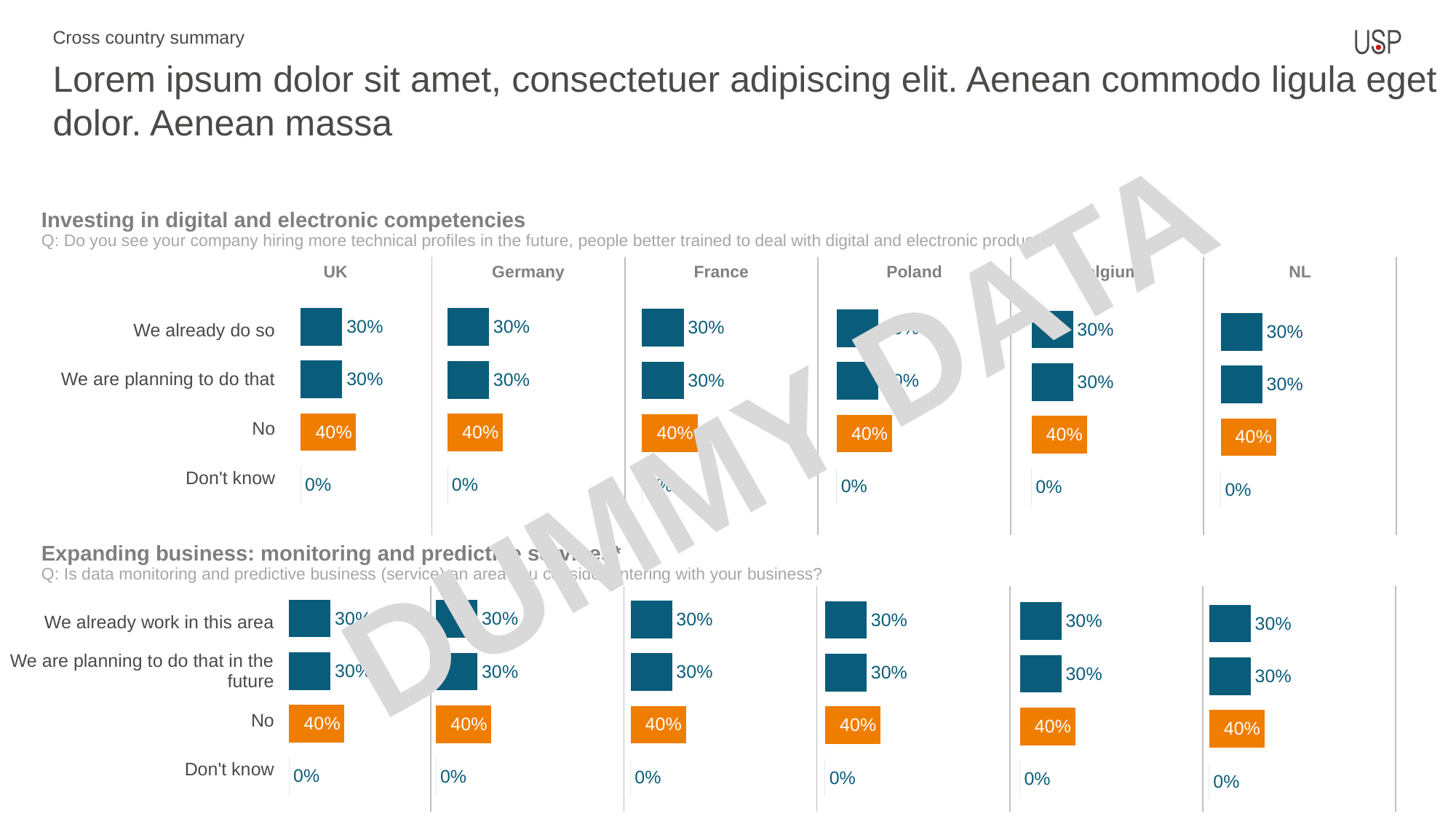
What type of chart is used for the 'Expanding business: monitoring and predictive services' section? Bar chart In the 'Expanding business: monitoring and predictive services' chart for NL, what is the value for 'We already work in this area'? 30% In the 'Expanding business: monitoring and predictive services' chart for France, which category has the lowest value? Don't know In the 'Investing in digital and electronic competencies' chart for Germany, what is the value for 'We already do so'? 30% In the 'Investing in digital and electronic competencies' chart for the UK, which category has the highest value? No In the 'Investing in digital and electronic competencies' chart for France, what is the value for 'Don't know'? 0% In the 'Expanding business: monitoring and predictive services' chart for Germany, which is larger: 'No' or 'We are planning to do that in the future'? No In the 'Investing in digital and electronic competencies' chart for Germany, what is the difference between 'No' and 'We are planning to do that'? 10% How many response categories are shown in each 'Investing in digital and electronic competencies' chart? 4 How many countries are shown across the top of the 'Investing in digital and electronic competencies' charts? 6 In the 'Expanding business: monitoring and predictive services' chart for Poland, what is the value for 'No'? 40% In the 'Investing in digital and electronic competencies' chart for the UK, what is the value for 'No'? 40%